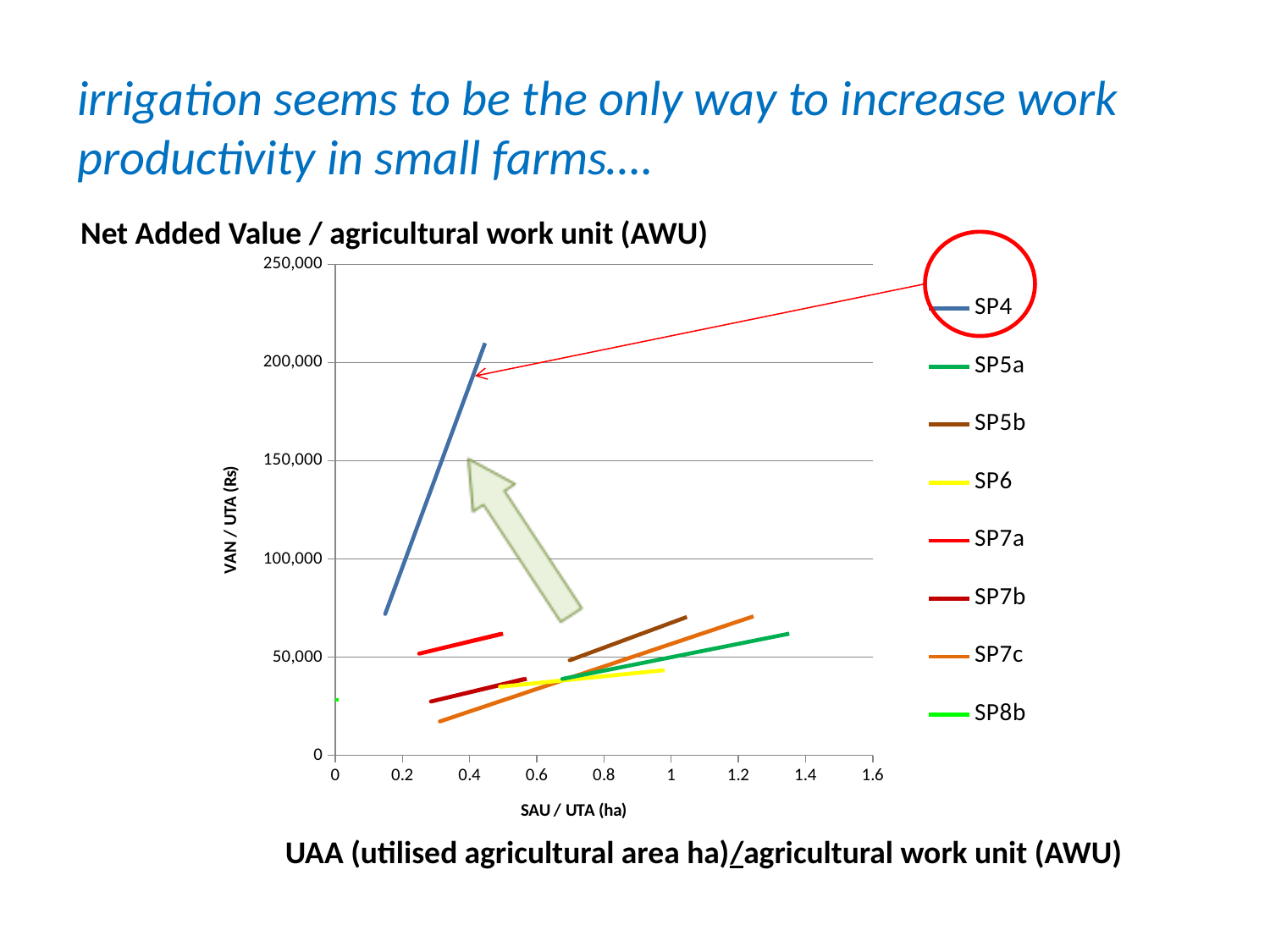
What kind of chart is shown on the slide? line chart Are the values of the SP6 line greater or less than 50,000? less Which legend entry is circled in red? SP4 Which series reaches higher values, SP4 or SP6? SP4 Is the highest point of the SP4 line greater or less than 200,000? greater Are the values of the SP7a line greater or less than 100,000? less What is the label of the vertical axis? VAN / UTA (Rs) Which series reaches the highest value on the chart? SP4 Does the SP4 line rise or fall as the x-axis value increases? rise Does the SP7c line rise or fall as the x-axis value increases? rise How many series does the legend list? 8